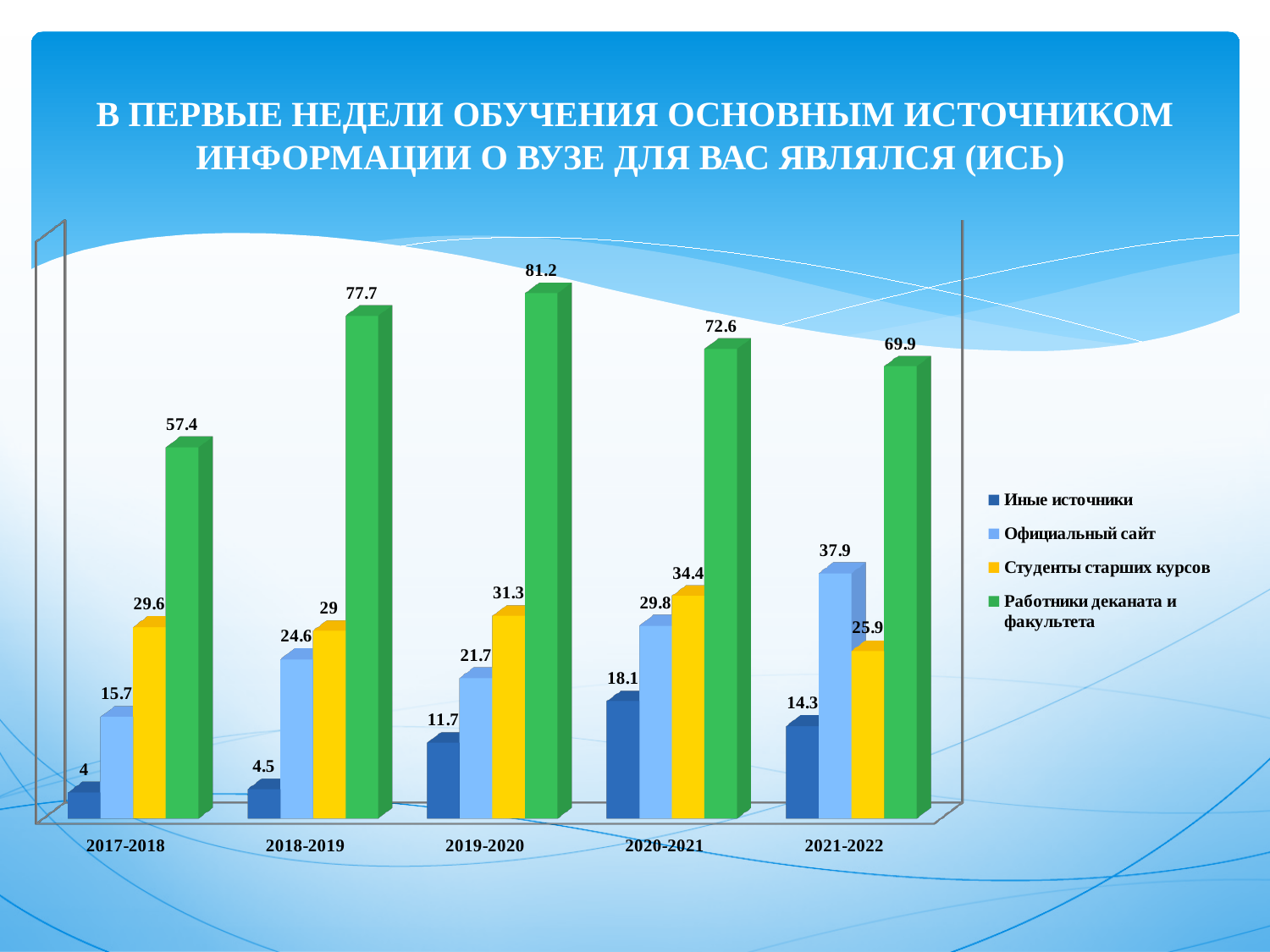
What is the value for Работники деканата и факультета in 2019-2020? 81.2 In which year is the value for Работники деканата и факультета the highest? 2019-2020 What is the difference between the Работники деканата и факультета values for 2018-2019 and 2017-2018? 20.3 What is the value for Студенты старших курсов in 2020-2021? 34.4 Which is larger in 2021-2022: Официальный сайт or Студенты старших курсов? Официальный сайт What is the value for Официальный сайт in 2021-2022? 37.9 What is the value for Иные источники in 2017-2018? 4 How many series does the legend list? 4 What kind of chart is shown on the slide? Bar chart In which year is the value for Иные источники the lowest? 2017-2018 Which colour represents Студенты старших курсов in the chart? Yellow How many academic years are shown on the x axis? 5